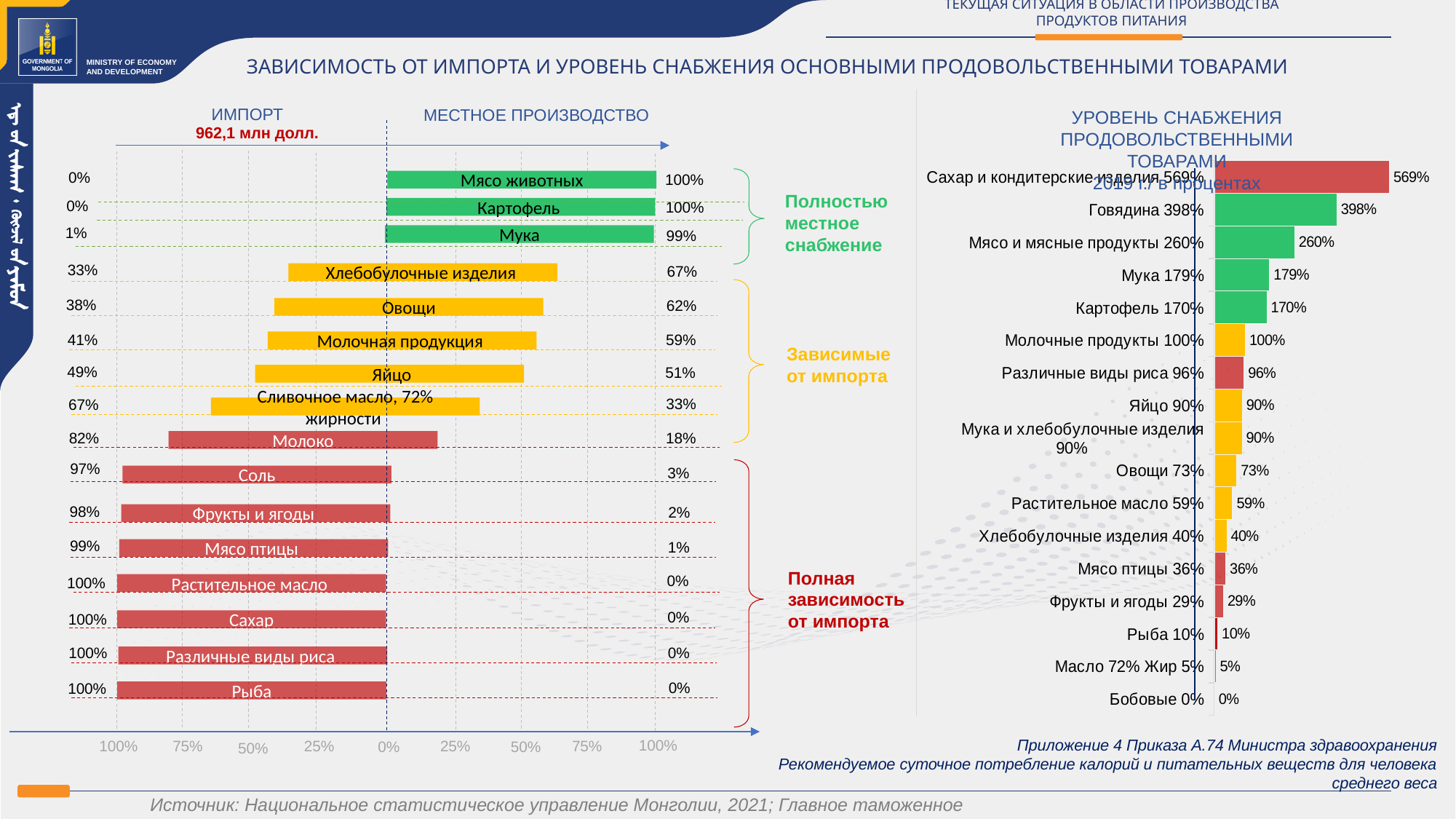
In the left chart on import dependence, what is the difference between the import shares of Сливочное масло, 72% жирности and Овощи? 29% In the right chart on the level of food supply in 2019, what is the value for Говядина? 398% In the right chart on the level of food supply in 2019, what is the difference between the values for Мука and Картофель? 9% In the left chart on import dependence, what is the import share for Яйцо? 49% In the left chart on import dependence, what total import value is printed under the ИМПОРТ heading? 962,1 млн долл. What type of chart is the right chart on the level of food supply in 2019? Bar chart In the left chart on import dependence, which has the larger local production share, Молочная продукция or Соль? Молочная продукция In the left chart on import dependence, what is the import share for Молоко? 82% In the right chart on the level of food supply in 2019, which category has the lowest value? Бобовые In the left chart on import dependence, how many product categories are shown? 16 In the left chart on import dependence, what is the local production share for Хлебобулочные изделия? 67% In the right chart on the level of food supply in 2019, which category has the highest value? Сахар и кондитерские изделия